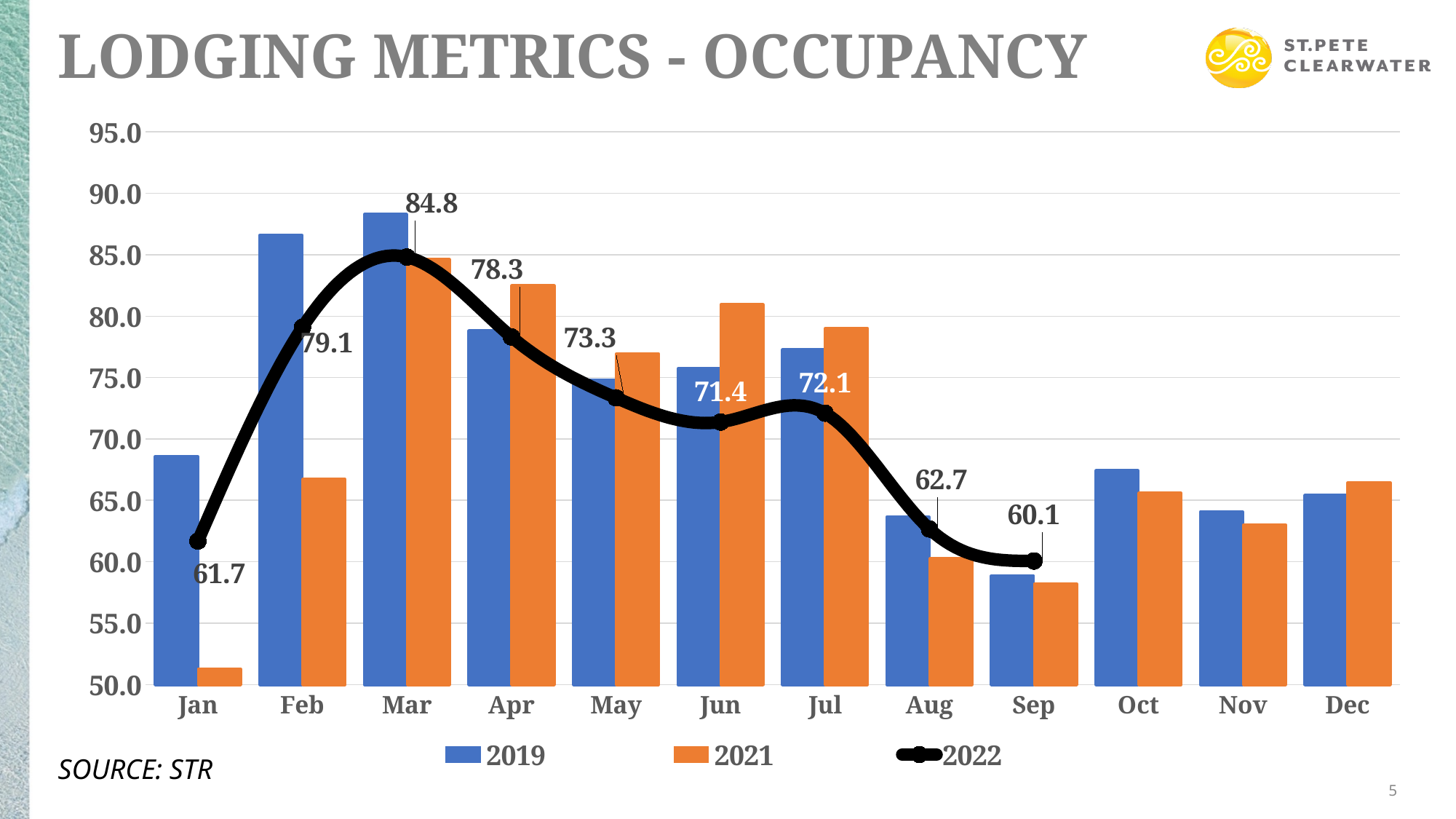
How many months are shown on the x axis? 12 Is the 2021 value for January greater or less than 55.0? less Which month has the lowest 2022 occupancy value shown? Sep What is the source cited for the chart data? STR Which month has the highest 2022 occupancy value? Mar What is the 2022 occupancy value for January? 61.7 Is the 2019 value for February greater or less than 85.0? greater Which is larger, the 2022 value for June or for July? July What is the 2022 occupancy value for September? 60.1 What is the 2022 occupancy value for March? 84.8 How many series does the legend list? 3 What is the difference between the 2022 values for March and September? 24.7